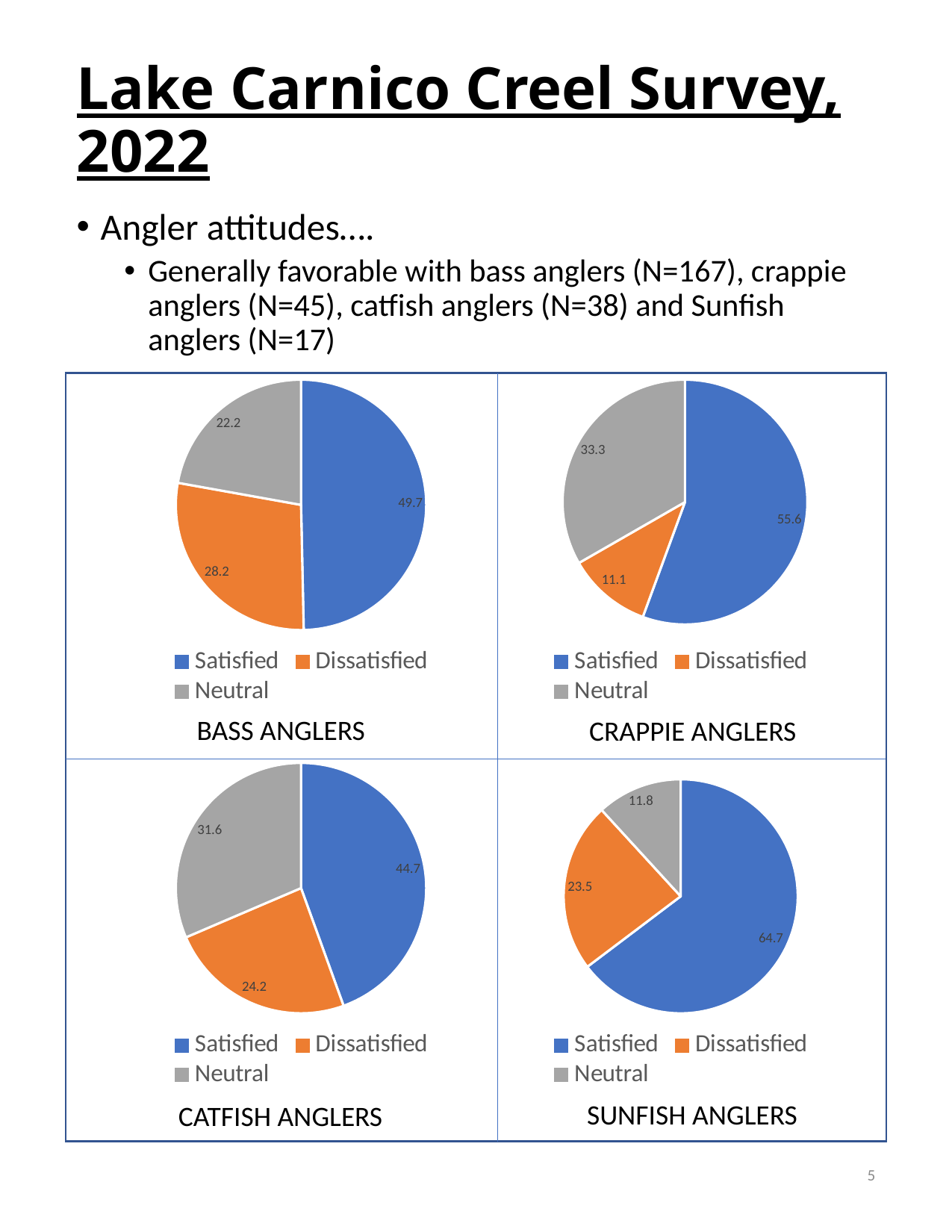
How many entries does the legend of the Bass Anglers chart list? 3 In the Sunfish Anglers pie chart, what colour is the Neutral slice? Gray In the Catfish Anglers pie chart, what is the value for Dissatisfied? 24.2 In the Sunfish Anglers pie chart, which is larger, Dissatisfied or Neutral? Dissatisfied In the Bass Anglers pie chart, what is the difference between the Dissatisfied and Neutral values? 6 In the Crappie Anglers pie chart, which category has the smallest slice? Dissatisfied In the Bass Anglers pie chart, what is the value for Satisfied? 49.7 In the Crappie Anglers pie chart, what is the value for Neutral? 33.3 How many slices does the Crappie Anglers pie chart have? 3 In the Catfish Anglers pie chart, which category has the largest slice? Satisfied What kind of chart is used for Catfish Anglers? Pie chart In the Sunfish Anglers pie chart, what is the value for Satisfied? 64.7